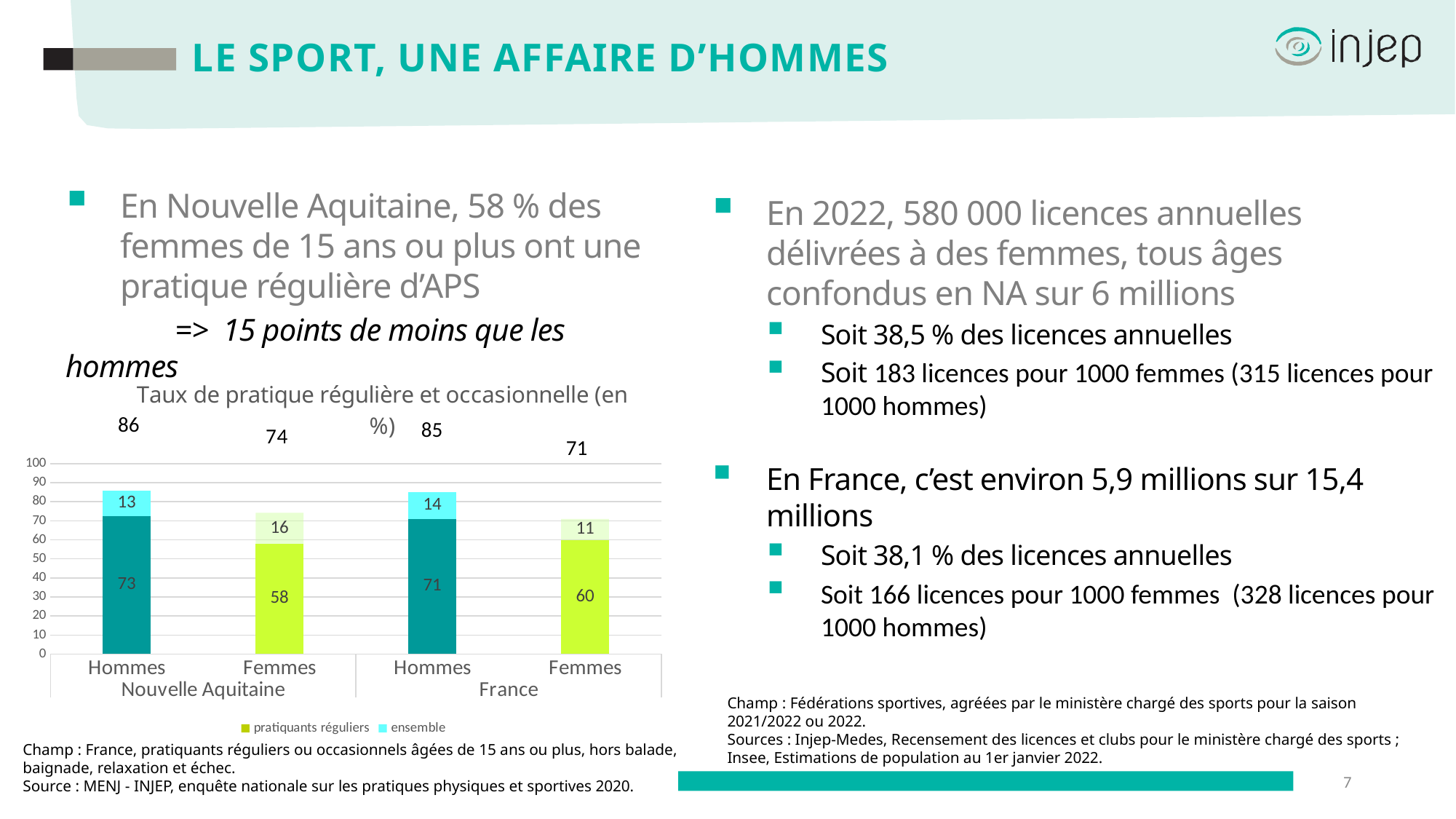
Which bar has the lowest total? Femmes (France) How many bars are plotted in the chart? 4 What kind of chart is shown on the slide? stacked bar chart What is the total shown above the bar for Femmes in France? 71 Which bar has the highest total? Hommes (Nouvelle Aquitaine) What is the title of the chart? Taux de pratique régulière et occasionnelle (en %) What is the total shown above the bar for Hommes in Nouvelle Aquitaine? 86 What is the value of 'pratiquants réguliers' for Hommes in France? 71 What is the difference between the 'pratiquants réguliers' values for Hommes and Femmes in Nouvelle Aquitaine? 15 Is the 'pratiquants réguliers' value for Femmes in France larger or smaller than for Femmes in Nouvelle Aquitaine? larger How many series does the chart legend list? 2 What is the value of 'pratiquants réguliers' for Femmes in Nouvelle Aquitaine? 58